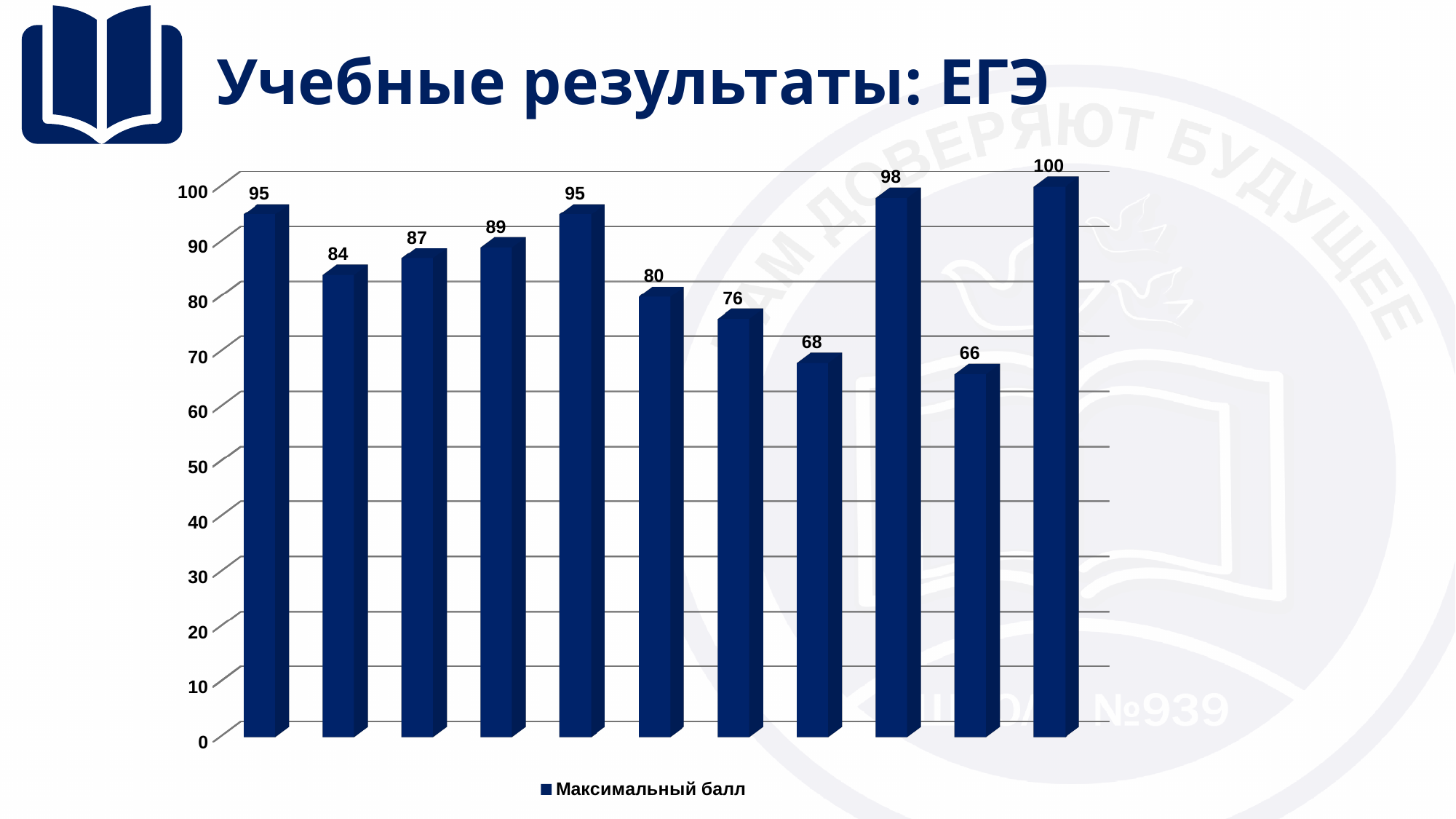
What is the title of the slide containing the chart? Учебные результаты: ЕГЭ What is the value of the first (leftmost) bar? 95 What is the highest value shown in the chart? 100 How many bars are plotted in the chart? 11 What is the value of the seventh bar from the left? 76 What is the lowest value shown in the chart? 66 What is the difference between the ninth bar (98) and the tenth bar (66)? 32 Which is larger: the value of the second bar or the value of the third bar? the third bar (87) What kind of chart is shown on the slide? bar chart How many series does the legend list? 1 What is the name of the series shown in the legend? Максимальный балл What is the value of the last (rightmost) bar? 100